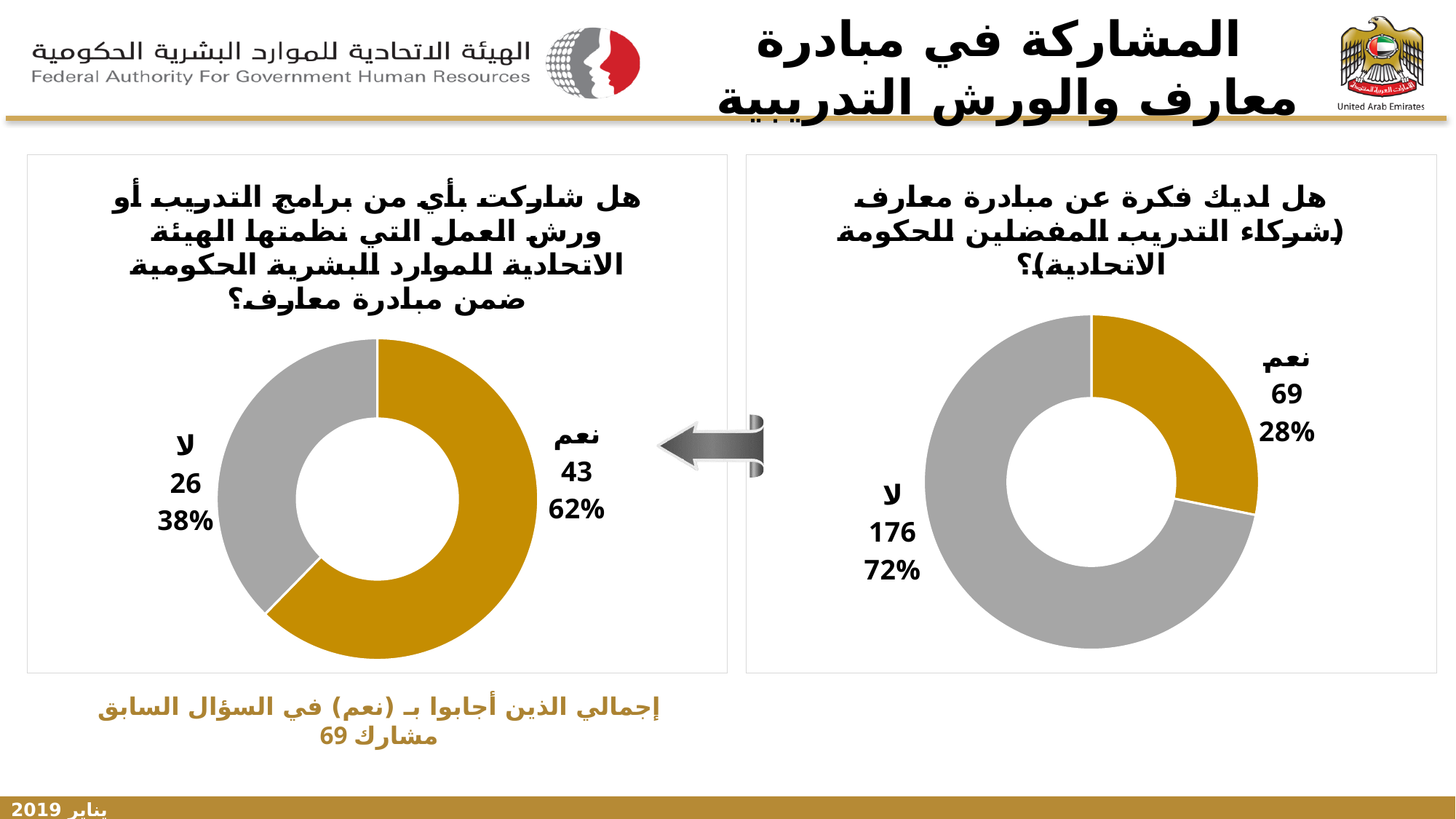
On the right-hand chart, what colour is the نعم slice? Gold/orange On the left-hand chart, what is the difference between the number of نعم and لا responses? 17 On the left-hand chart, which answer has the largest share? نعم On the left-hand chart (هل شاركت بأي من برامج التدريب), how many respondents answered نعم? 43 How many categories does the left-hand chart show? 2 What type of chart is used on the right-hand side of the slide? Donut (pie) chart On the left-hand chart, what is the total number of responses (نعم plus لا)? 69 On the right-hand chart, which answer has the larger share, نعم or لا? لا On the left-hand chart (هل شاركت بأي من برامج التدريب), what percentage answered لا? 38% On the right-hand chart, what is the difference between the number of لا and نعم responses? 107 On the right-hand chart (هل لديك فكرة عن مبادرة معارف), what percentage answered لا? 72% On the right-hand chart (هل لديك فكرة عن مبادرة معارف), how many respondents answered نعم? 69